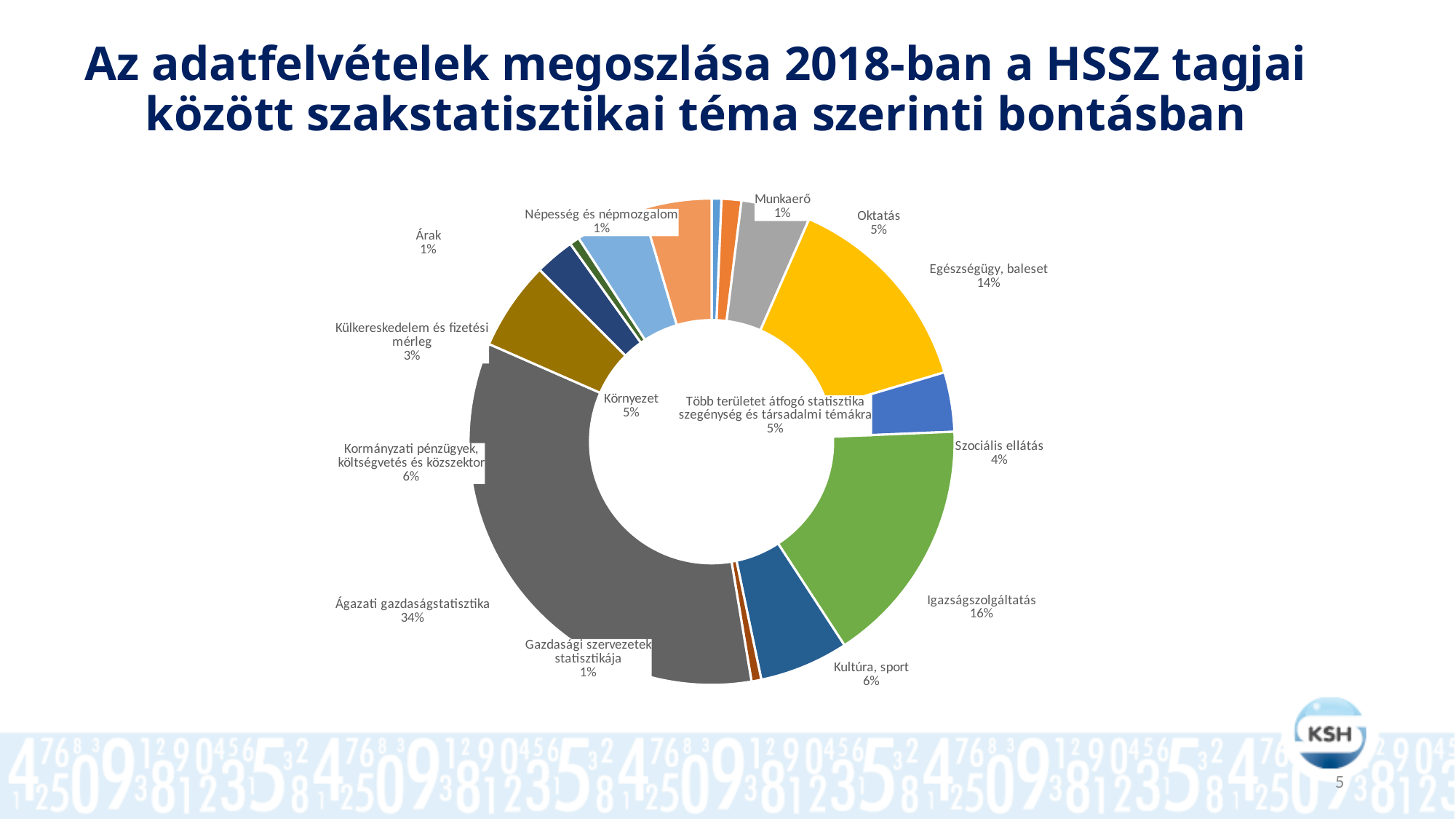
What percentage is shown for Egészségügy, baleset? 14% Which has a larger share, Kultúra, sport or Oktatás? Kultúra, sport What percentage is shown for Igazságszolgáltatás? 16% What kind of chart is shown on the slide? Doughnut (pie) chart What percentage is shown for Szociális ellátás? 4% What share of the data collections does Ágazati gazdaságstatisztika account for? 34% Which has a larger share, Egészségügy, baleset or Kormányzati pénzügyek, költségvetés és közszektor? Egészségügy, baleset What year does the chart title refer to? 2018 Which category has the largest share of the chart? Ágazati gazdaságstatisztika What percentage is shown for Külkereskedelem és fizetési mérleg? 3% What is the difference in percentage points between Ágazati gazdaságstatisztika and Igazságszolgáltatás? 18 percentage points What is the difference in percentage points between Igazságszolgáltatás and Egészségügy, baleset? 2 percentage points